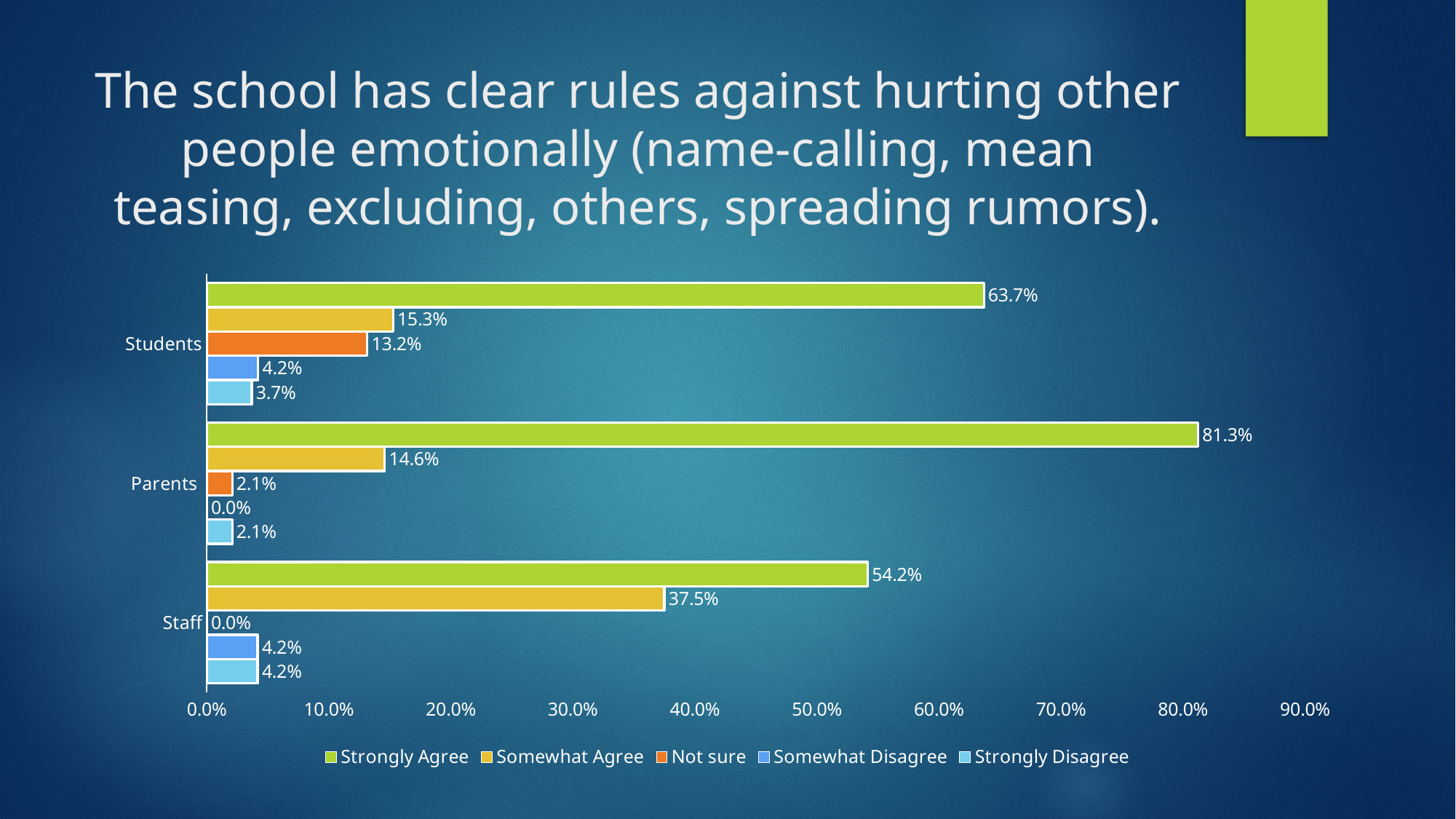
How many groups are shown on the vertical axis? 3 Which series is shown in green in the legend? Strongly Agree What is the Somewhat Disagree value for Students? 4.2% Which group has the highest Strongly Agree value? Parents What is the Not sure value for Parents? 2.1% What is the Somewhat Agree value for Staff? 37.5% Which group has the lowest Strongly Agree value? Staff What kind of chart is shown on the slide? Bar chart What percentage of Students strongly agree that the school has clear rules against hurting other people emotionally? 63.7% How many series does the legend list? 5 What is the difference between the Strongly Agree values for Parents and Students? 17.6% Which is larger, the Not sure value for Students or the Not sure value for Parents? Students